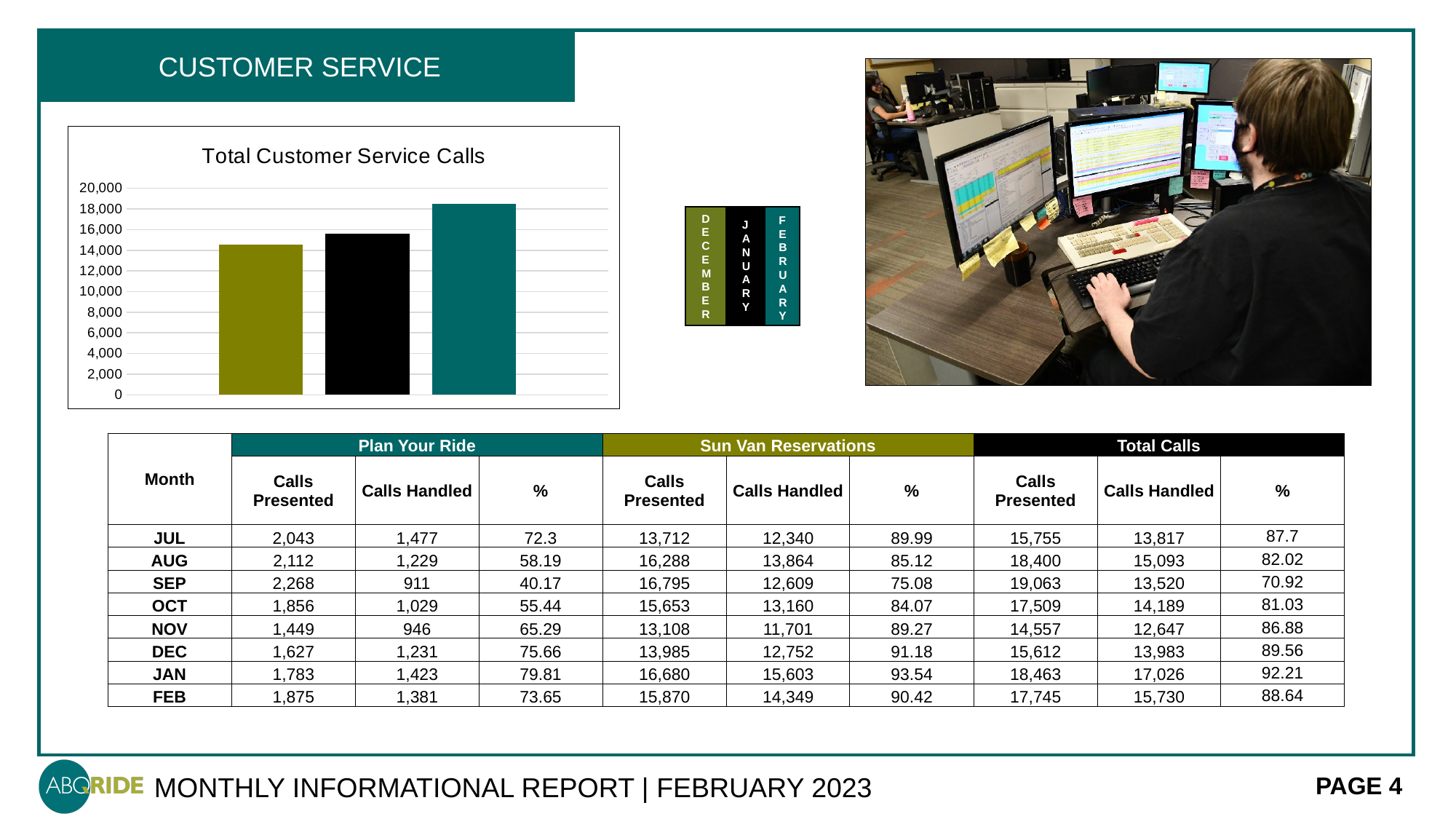
In the "Total Customer Service Calls" chart, is the value for December greater or less than 12,000? greater What kind of chart is the "Total Customer Service Calls" chart? bar chart In the "Total Customer Service Calls" chart, is the bar for January larger or smaller than the bar for December? larger What is the title of the bar chart on the slide? Total Customer Service Calls In the "Total Customer Service Calls" chart, is the value for January greater or less than 14,000? greater How many bars are plotted in the "Total Customer Service Calls" chart? 3 Which month has the highest bar in the "Total Customer Service Calls" chart? February In the "Total Customer Service Calls" chart, is the value for February greater or less than 16,000? greater Do the bars in the "Total Customer Service Calls" chart rise or fall from December to February? rise What colour is the February bar in the "Total Customer Service Calls" chart? teal Which month has the lowest bar in the "Total Customer Service Calls" chart? December